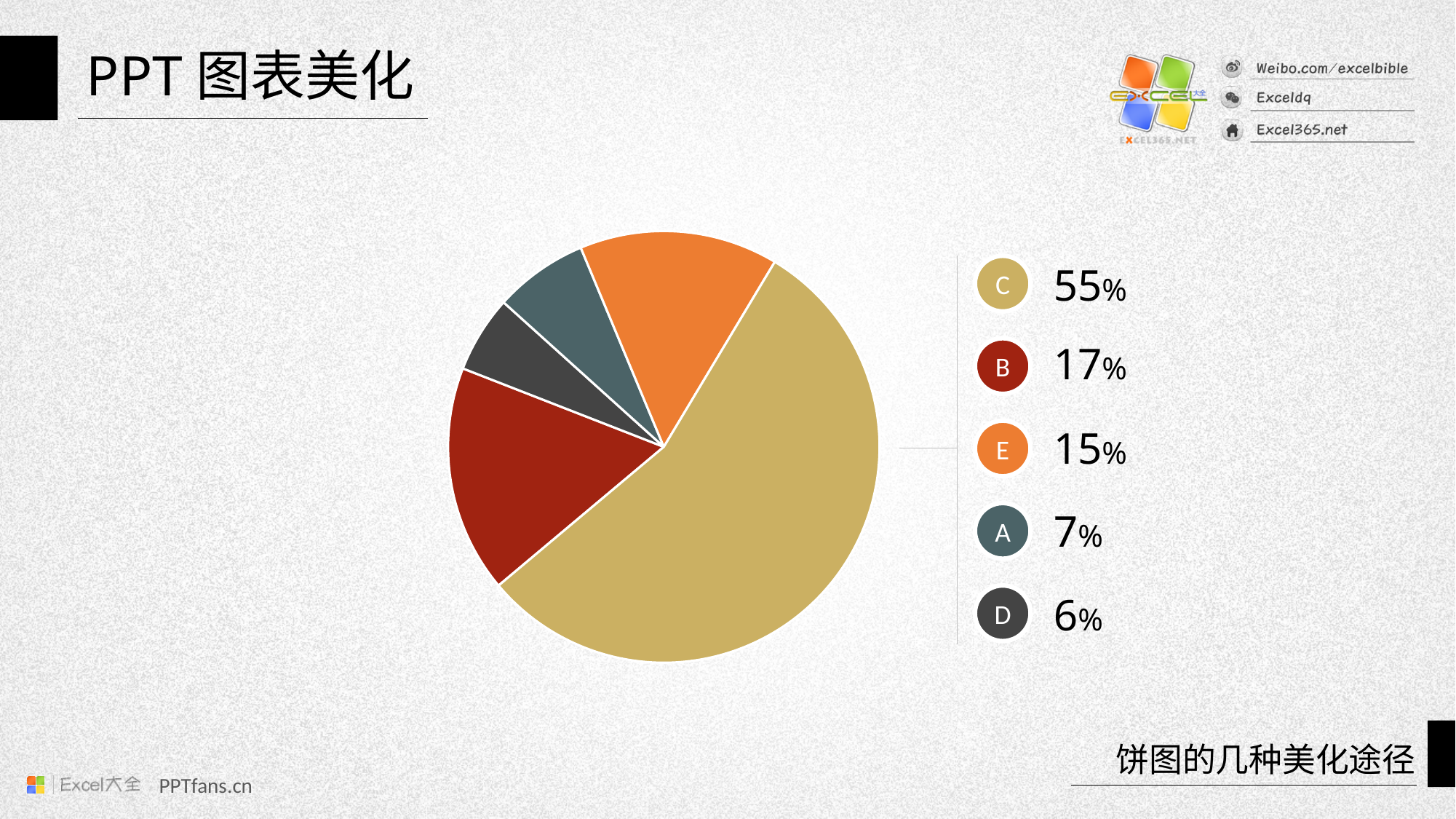
Which is larger, the share of category B or the share of category E? B What share of the pie does category A have? 7% What share of the pie does category B have? 17% What kind of chart is shown on the slide? pie chart What is the difference between the shares of category C and category B? 38% Which category has the largest slice of the pie? C What colour is the slice for category E? orange Which category has the smallest slice of the pie? D How many slices does the pie chart have? 5 What share of the pie does category D have? 6% What share of the pie does category E have? 15% What share of the pie does category C have? 55%